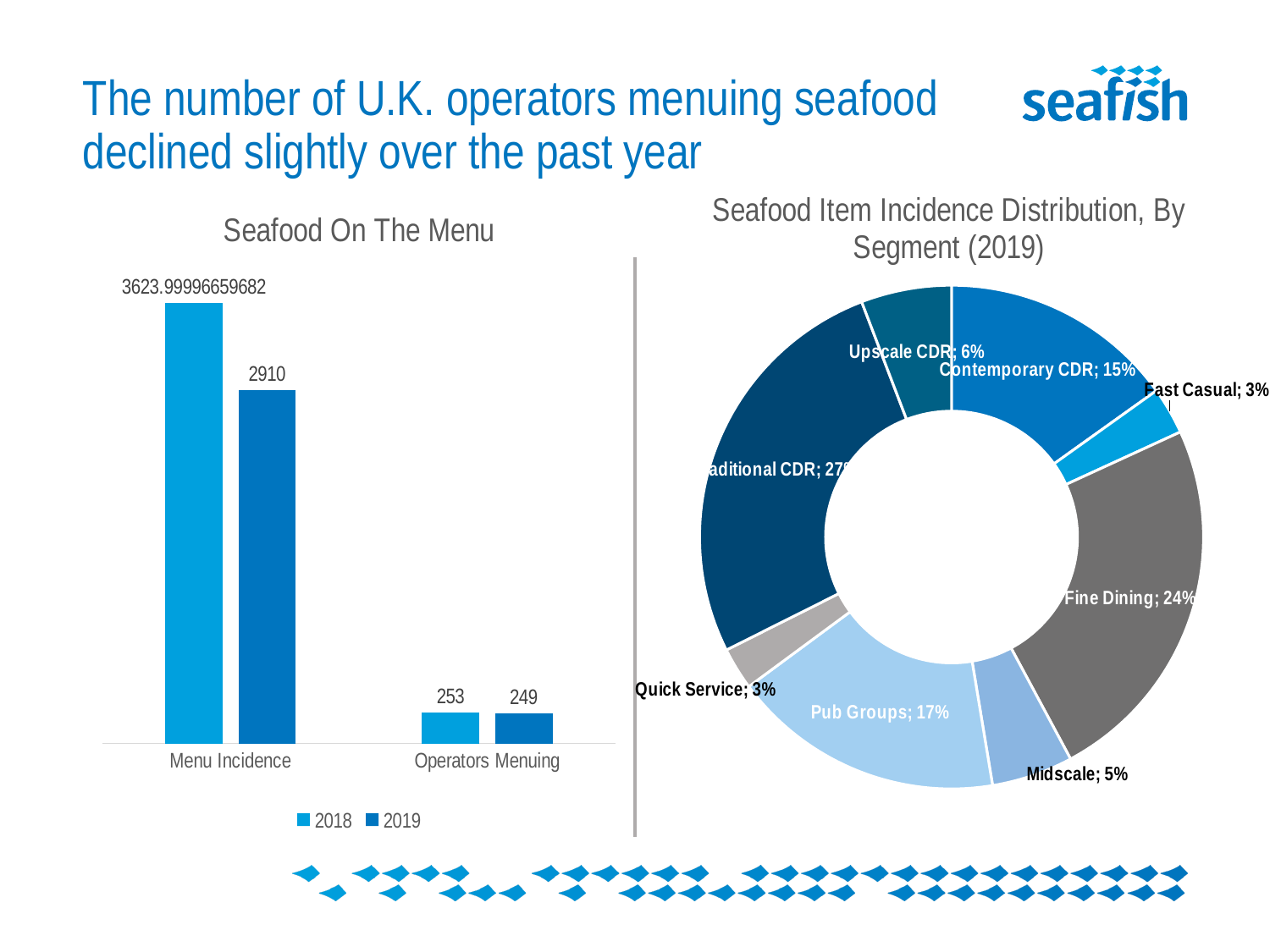
How many series does the legend of the 'Seafood On The Menu' chart list? 2 In the 'Seafood Item Incidence Distribution, By Segment (2019)' chart, what share does Contemporary CDR have? 15% In the 'Seafood Item Incidence Distribution, By Segment (2019)' chart, what share does Pub Groups have? 17% In the 'Seafood On The Menu' chart, what is the difference between the 2018 and 2019 values for Operators Menuing? 4 How many segments are shown in the 'Seafood Item Incidence Distribution, By Segment (2019)' chart? 8 In the 'Seafood Item Incidence Distribution, By Segment (2019)' chart, what share does Fine Dining have? 24% What kind of chart is 'Seafood On The Menu'? Bar chart In the 'Seafood Item Incidence Distribution, By Segment (2019)' chart, which is larger, Upscale CDR or Midscale? Upscale CDR In the 'Seafood On The Menu' chart, what is the 2019 value for Menu Incidence? 2910 In the 'Seafood On The Menu' chart, which year has the larger value for Menu Incidence, 2018 or 2019? 2018 In the 'Seafood On The Menu' chart, what is the 2019 value for Operators Menuing? 249 In the 'Seafood On The Menu' chart, what is the 2018 value for Operators Menuing? 253